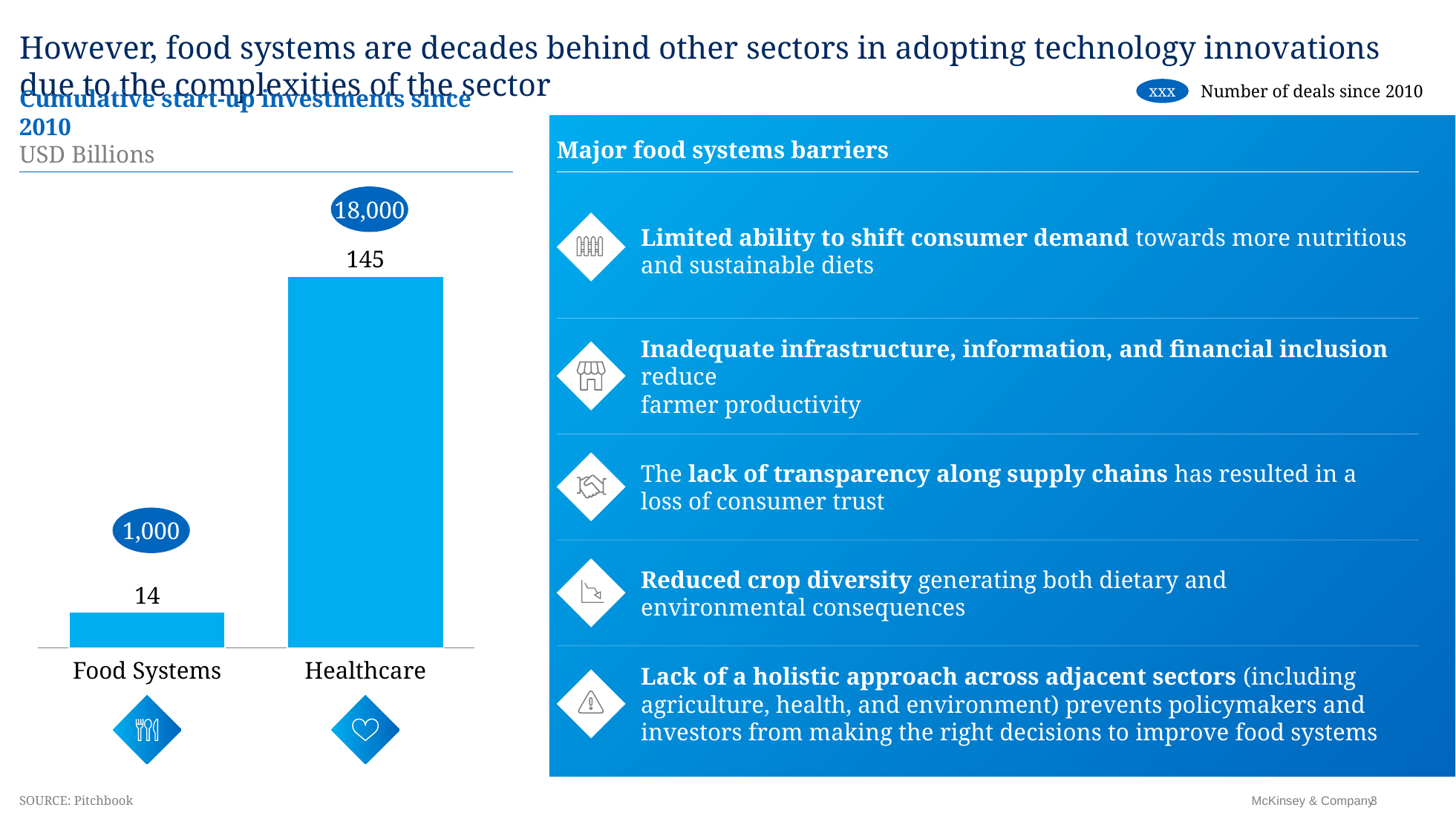
What is the difference in cumulative start-up investment between Healthcare and Food Systems, in USD billions? 131 Which category has the highest cumulative start-up investment? Healthcare What is the difference in the number of deals since 2010 between Healthcare and Food Systems? 17,000 What is the cumulative start-up investment since 2010 for Healthcare, in USD billions? 145 How many categories are shown in the bar chart? 2 What is the cumulative start-up investment since 2010 for Food Systems, in USD billions? 14 What unit is the cumulative start-up investment chart measured in? USD Billions Which has more deals since 2010, Food Systems or Healthcare? Healthcare Which category has the lowest cumulative start-up investment? Food Systems What type of chart is used to show cumulative start-up investments? Bar chart How many deals since 2010 are shown for Healthcare? 18,000 How many deals since 2010 are shown for Food Systems? 1,000